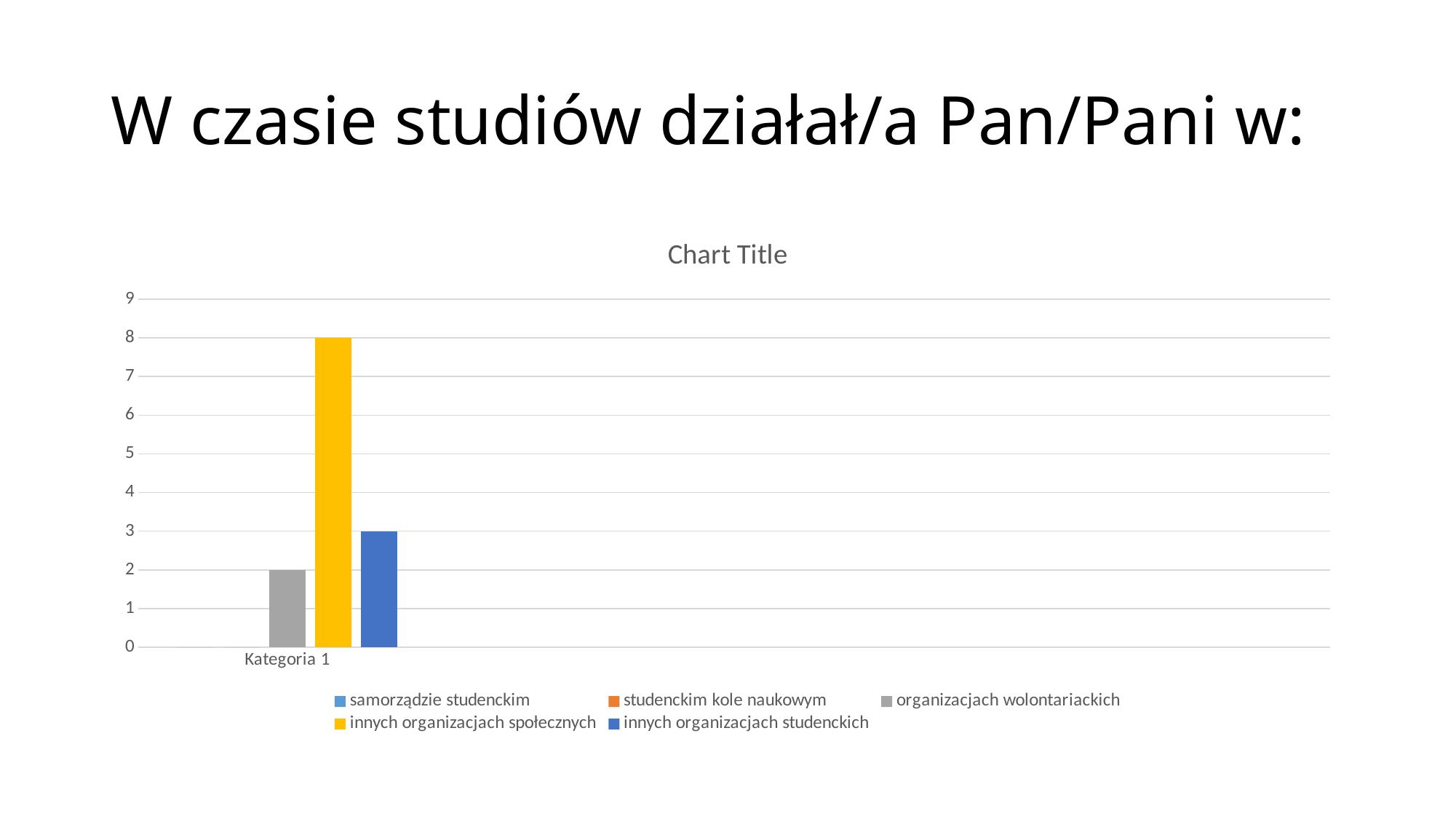
How many series does the legend list? 5 What is the value for 'innych organizacjach społecznych' in Kategoria 1? 8 How many categories are shown on the x axis? 1 Which series has the highest bar? innych organizacjach społecznych What is the difference between the values for 'innych organizacjach społecznych' and 'organizacjach wolontariackich'? 6 What kind of chart is shown on the slide? bar chart Is the value for 'innych organizacjach społecznych' greater or less than 5? greater What is the difference between the values for 'innych organizacjach społecznych' and 'innych organizacjach studenckich'? 5 What is the title shown above the chart? Chart Title What is the value for 'organizacjach wolontariackich' in Kategoria 1? 2 What is the value for 'innych organizacjach studenckich' in Kategoria 1? 3 Which is larger: the value for 'innych organizacjach studenckich' or for 'organizacjach wolontariackich'? innych organizacjach studenckich